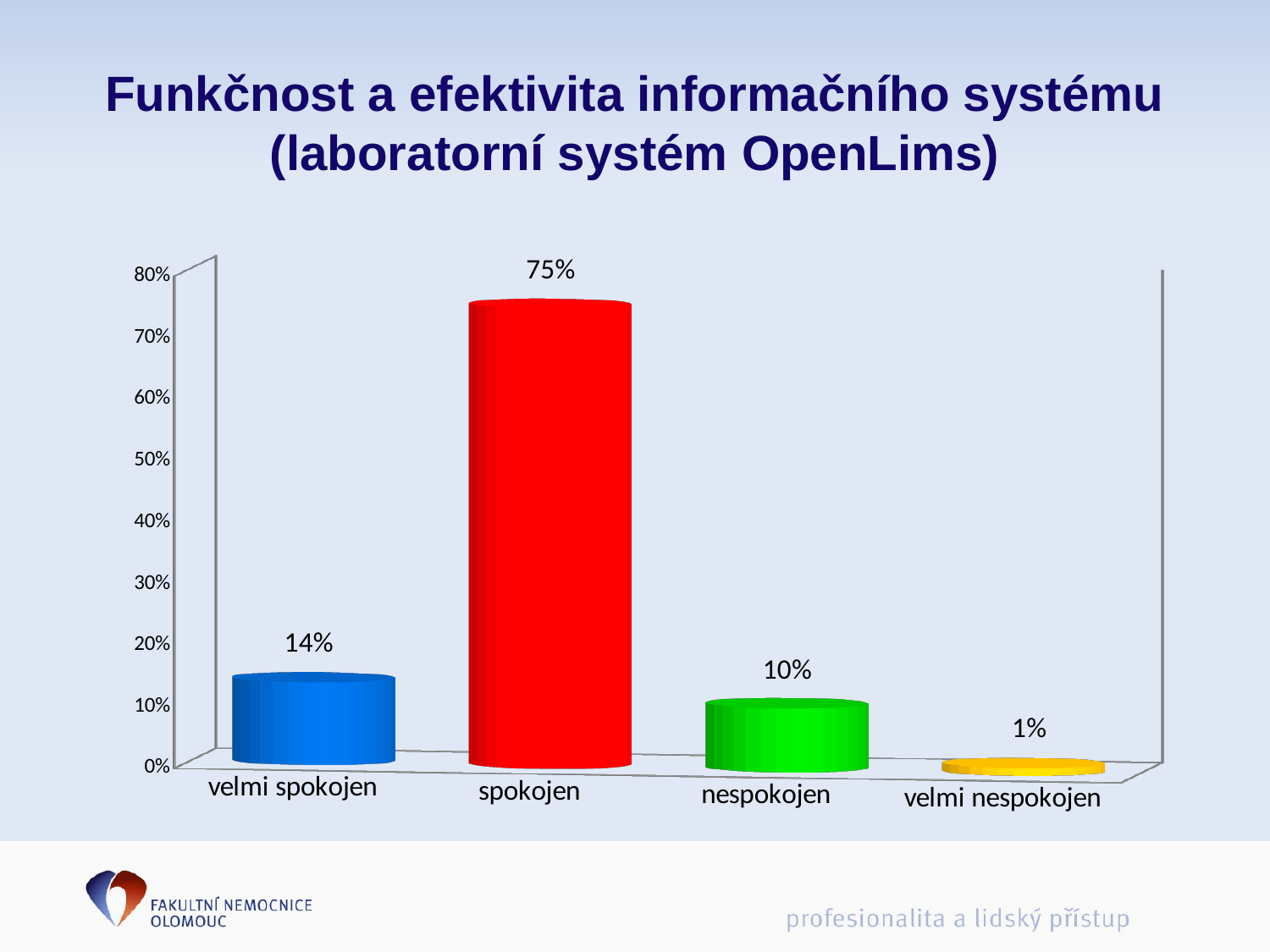
What is the difference between the values for "spokojen" and "velmi spokojen"? 61% What kind of chart is shown on the slide? bar chart What colour is the bar for "spokojen"? red Which is larger, the value for "velmi spokojen" or the value for "nespokojen"? velmi spokojen What is the value for "spokojen"? 75% What is the value for "velmi spokojen"? 14% What is the value for "velmi nespokojen"? 1% What is the difference between the values for "velmi spokojen" and "nespokojen"? 4% What is the value for "nespokojen"? 10% Which category has the highest value? spokojen How many categories are shown on the x axis? 4 Which category has the lowest value? velmi nespokojen